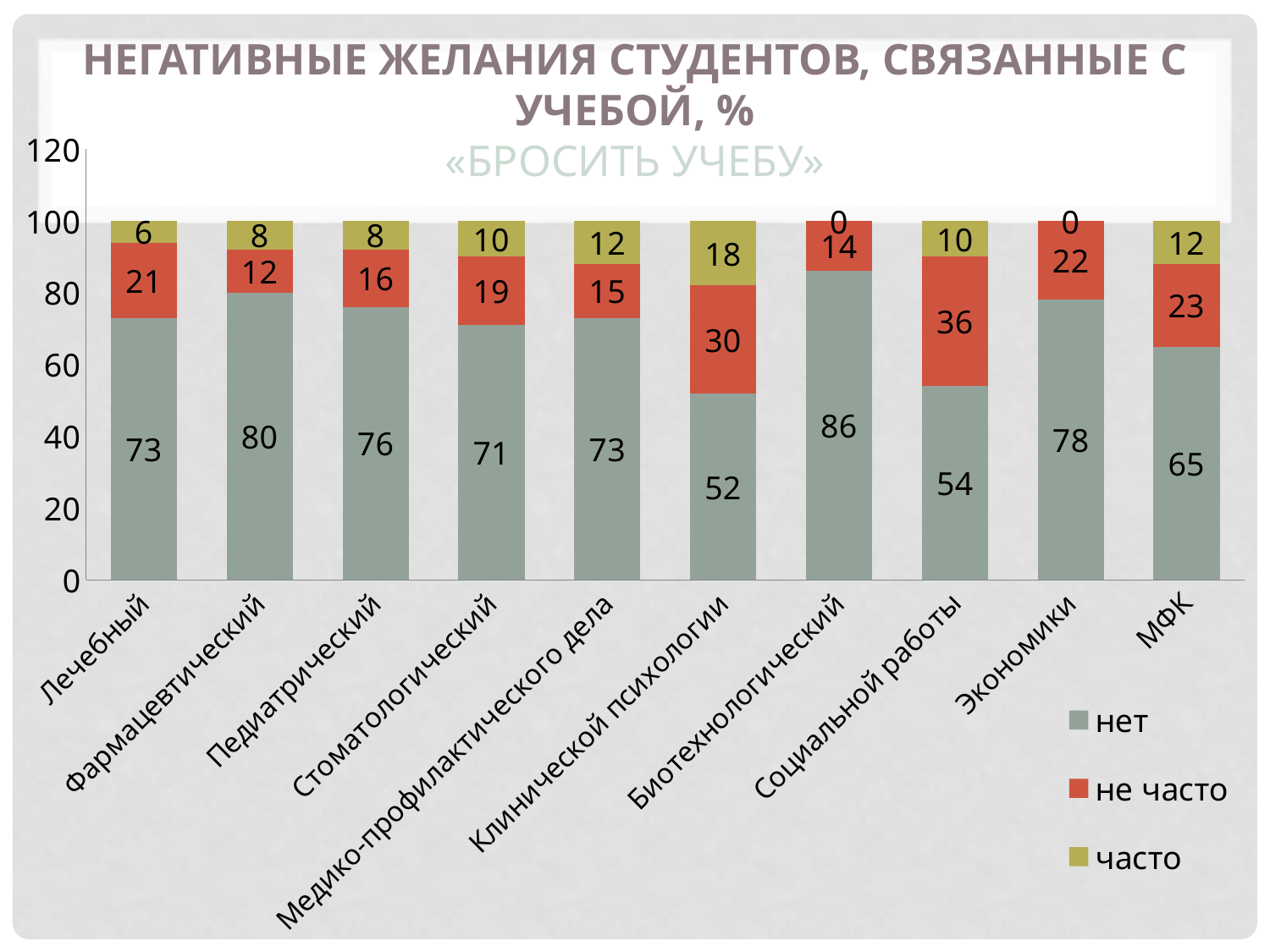
What is the difference between the "нет" values for Фармацевтический and МФК? 15 What is the value of "не часто" for Социальной работы? 36 How many series does the legend list? 3 Which faculty has the highest value for "не часто"? Социальной работы How many faculties (categories) are shown on the x axis? 10 Which faculties have a "часто" value of 0? Биотехнологический and Экономики What is the total of the stacked bar for Стоматологический? 100 What is the value of "часто" for Клинической психологии? 18 What type of chart is shown on the slide? stacked bar chart Which is larger: the "не часто" value for Лечебный or for Педиатрический? Лечебный What is the value of "нет" for Биотехнологический? 86 Which faculty has the lowest value for "нет"? Клинической психологии